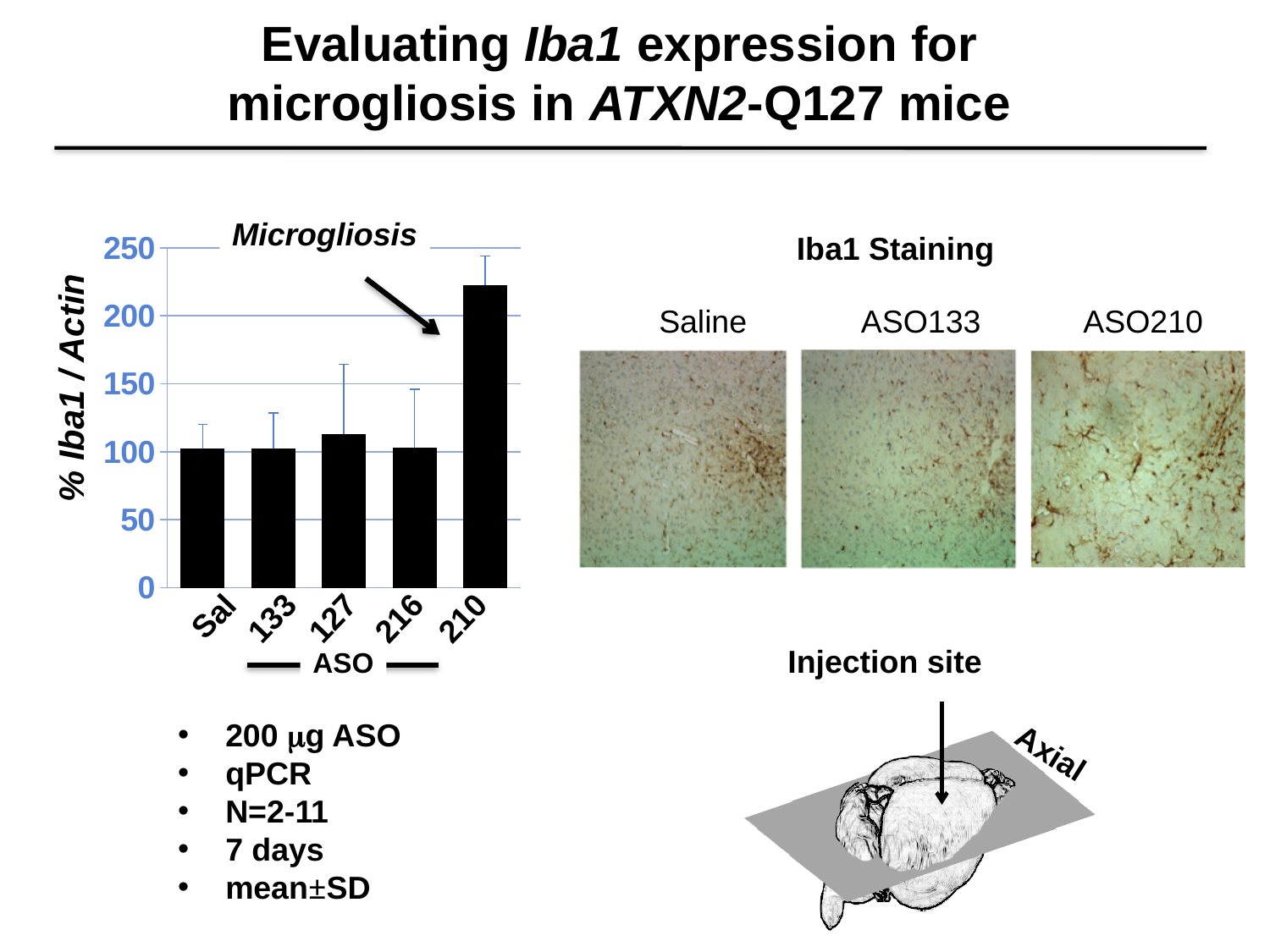
In the Microgliosis chart, which is larger, the value for 127 or the value for 210? 210 Is the value for 133 in the Microgliosis chart greater or less than 50? greater What is the title of the bar chart on the slide? Microgliosis Is the value for 127 in the Microgliosis chart greater or less than 150? less Is the value for 216 in the Microgliosis chart greater or less than 150? less What kind of chart is the Microgliosis chart? bar chart What is the maximum value shown on the y axis of the Microgliosis chart? 250 What is the y-axis label of the Microgliosis chart? % Iba1 / Actin In the Microgliosis chart, which is larger, the value for Sal or the value for 210? 210 How many categories are shown on the x axis of the Microgliosis chart? 5 Which category has the highest value in the Microgliosis chart? 210